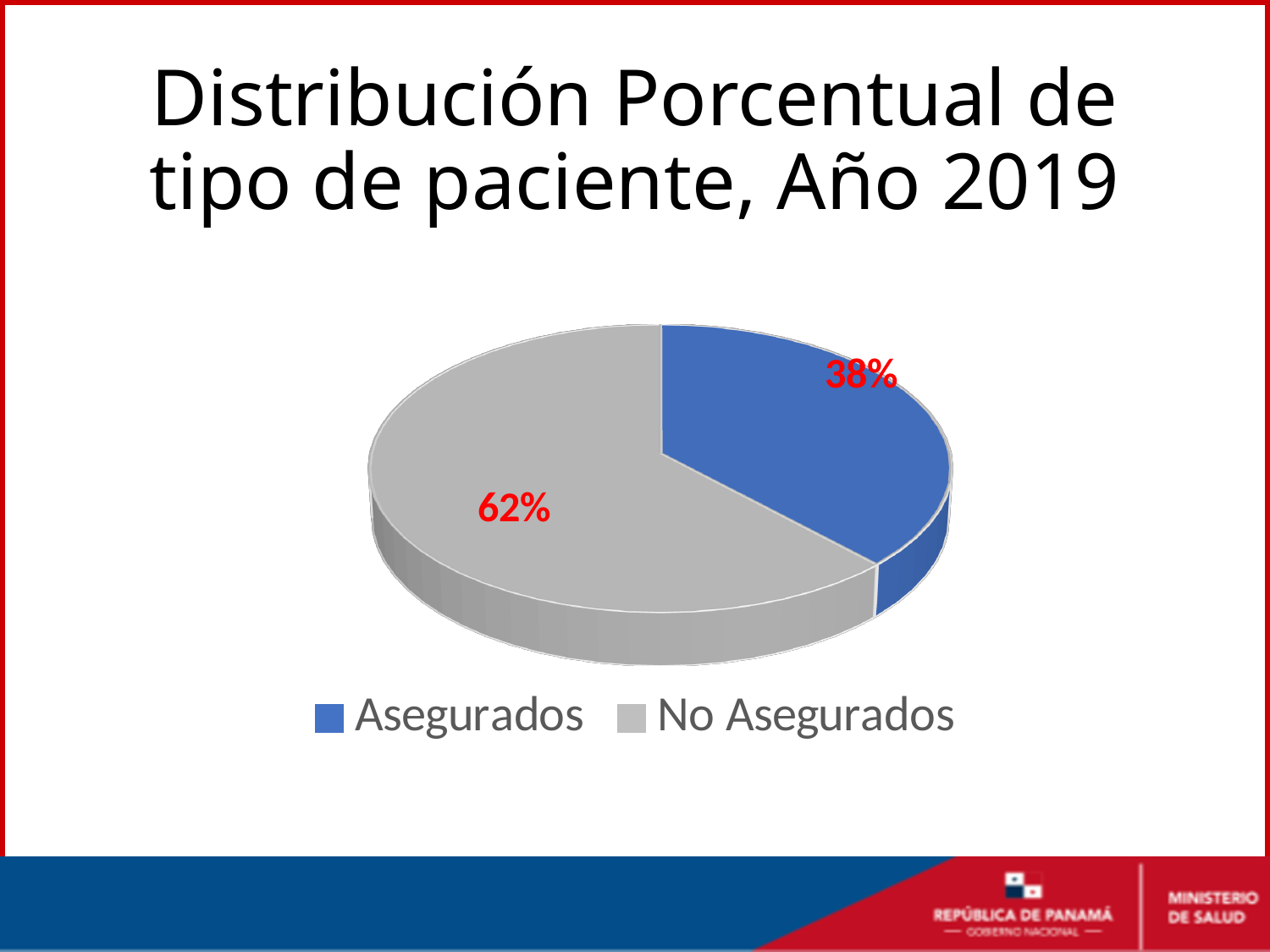
What kind of chart is shown on the slide? Pie chart What is the difference in percentage points between No Asegurados and Asegurados? 24 How many categories does the pie chart show? 2 Which category has the smallest share of the pie? Asegurados What is the title of the chart on the slide? Distribución Porcentual de tipo de paciente, Año 2019 What percentage of patients are No Asegurados? 62% What percentage of patients are Asegurados? 38% What colour is the Asegurados slice? Blue Which is larger, the share for Asegurados or for No Asegurados? No Asegurados Which category has the largest share of the pie? No Asegurados What share of the pie does the Asegurados slice represent? 38%